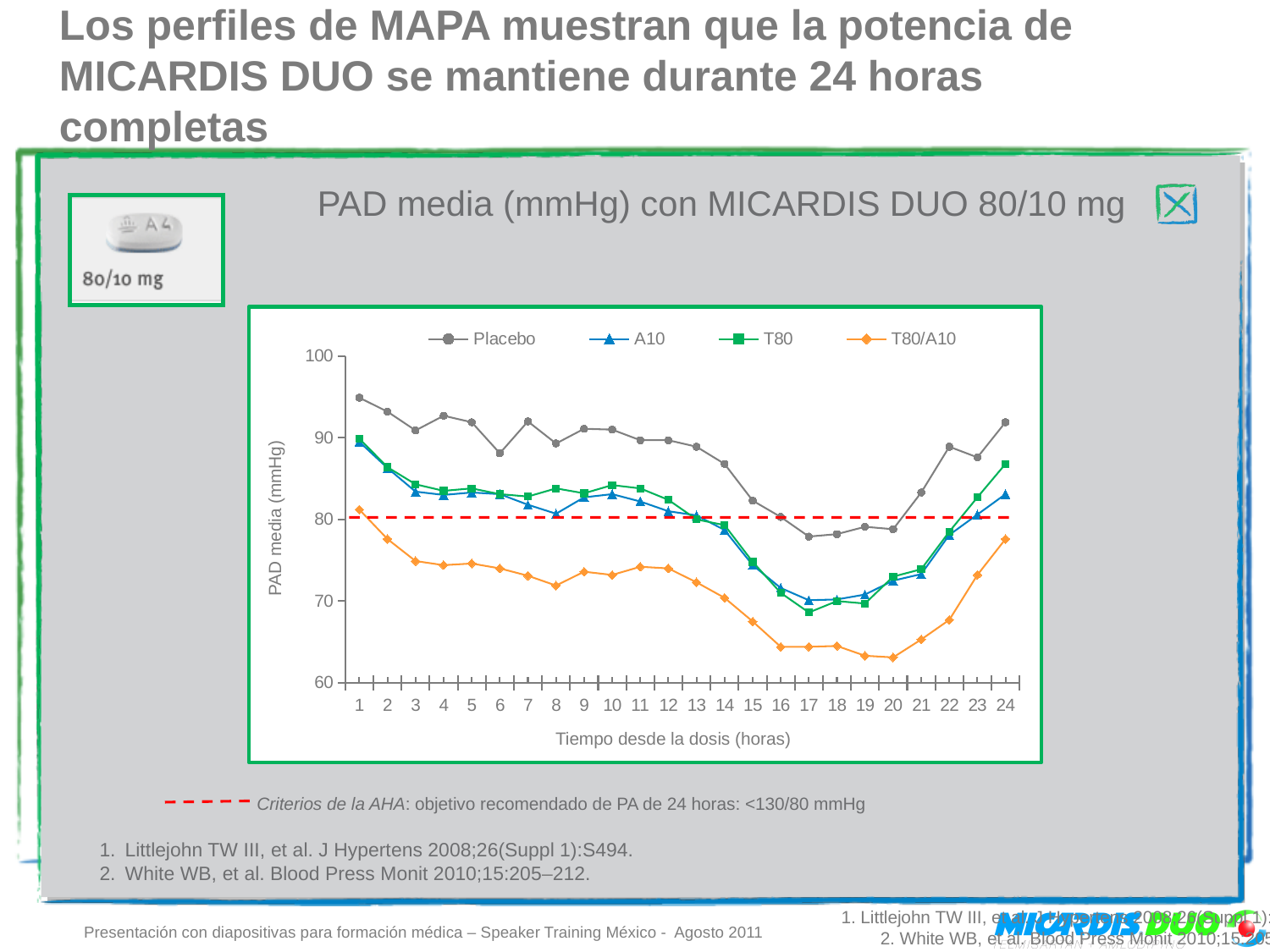
Does the T80/A10 series rise or fall from hour 1 to hour 20? fall What kind of chart is shown on the slide? line chart Is the value for A10 at hour 17 greater or less than 80? less Is the value for T80/A10 at hour 16 greater or less than 70? less Which series are listed in the legend? Placebo, A10, T80, T80/A10 Which series has the highest values across the 24 hours? Placebo Which series has the lowest values across the 24 hours? T80/A10 How many series does the legend list? 4 Is the value for T80/A10 at hour 20 greater or less than 70? less At hour 17, which is larger: the value for Placebo or the value for T80/A10? Placebo How many time points (hours) are plotted along the x axis? 24